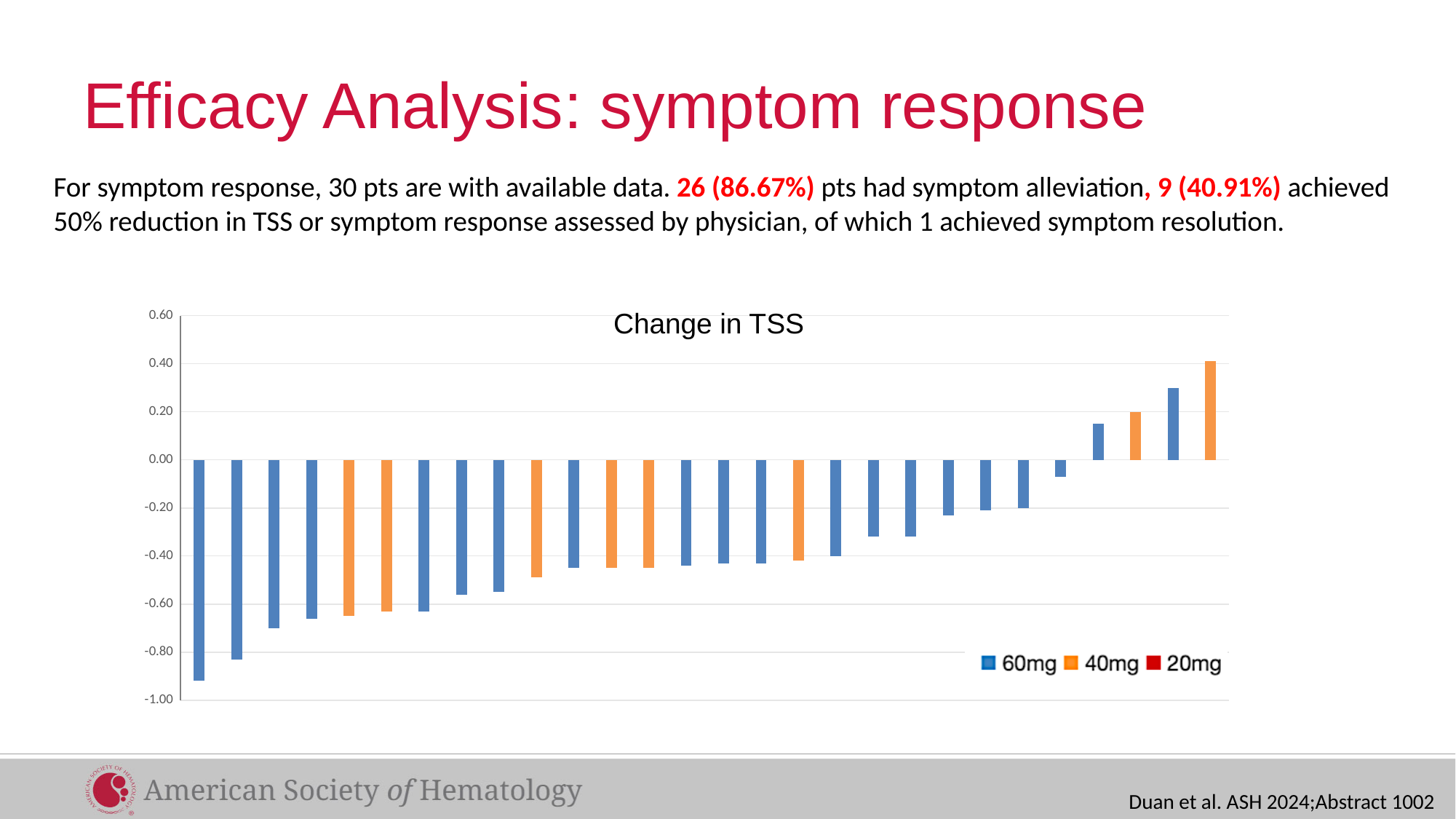
Is the value of the leftmost bar greater or less than -0.80? less Which dose groups are listed in the chart legend? 60mg, 40mg, 20mg How many bars in the chart show a positive change in TSS? 4 What kind of chart is shown on the slide? bar chart Do the bar values rise or fall moving from left to right along the x axis? rise How many series does the chart legend list? 3 Is the value of the second bar from the left greater or less than -0.60? less What is the title of the chart? Change in TSS Which dose group does the bar with the largest increase in TSS belong to? 40mg How many bars are plotted in the Change in TSS chart? 28 Which dose group does the bar with the largest decrease in TSS belong to? 60mg Is the value of the rightmost bar greater or less than 0.20? greater